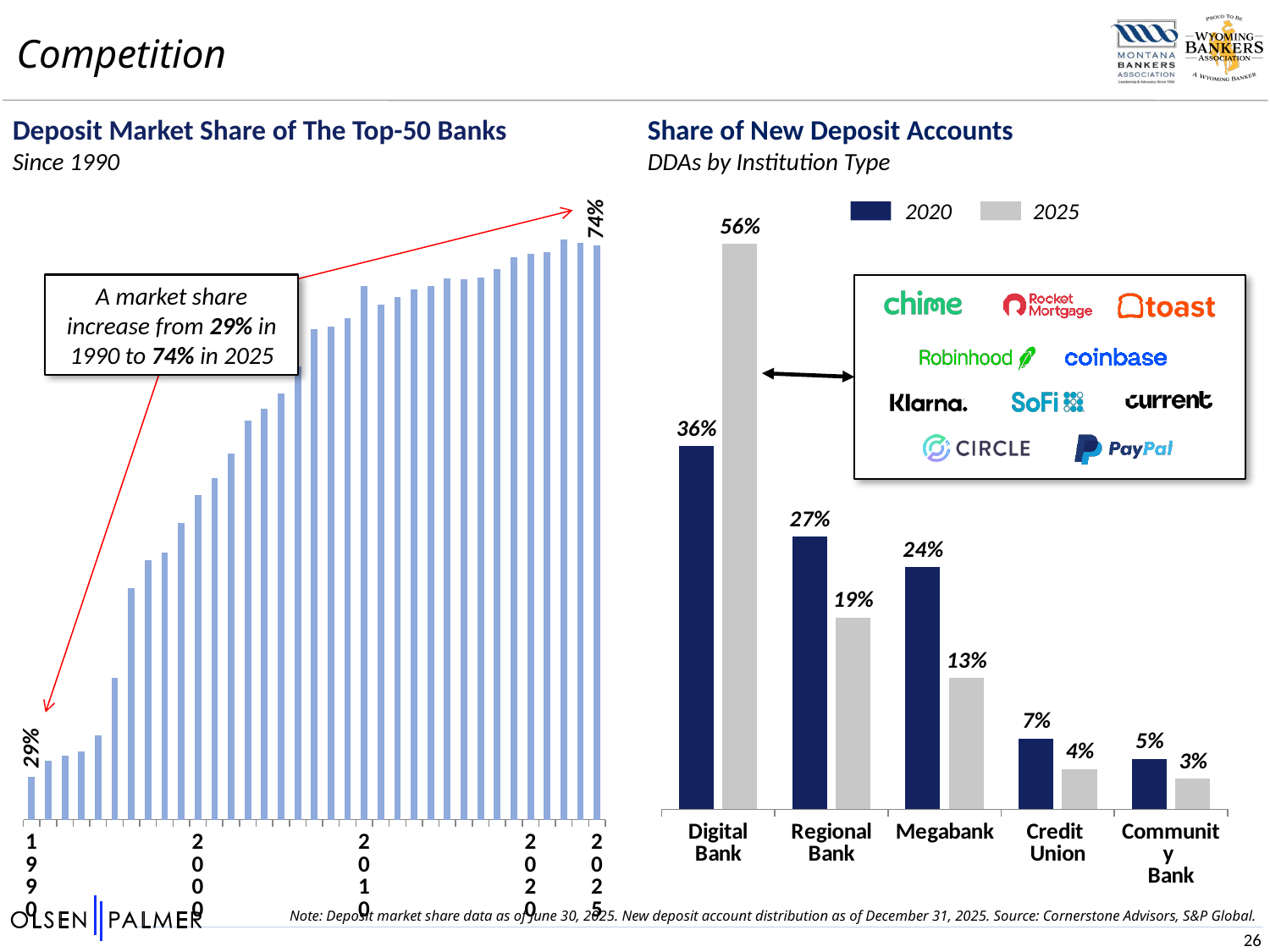
In the 'Share of New Deposit Accounts' chart, which is larger: the 2020 value for Credit Union or the 2020 value for Community Bank? Credit Union In the 'Share of New Deposit Accounts' chart, what is the 2025 value for Megabank? 13% What kind of chart is the 'Deposit Market Share of The Top-50 Banks' chart? Bar chart In the 'Share of New Deposit Accounts' chart, what is the 2020 value for Regional Bank? 27% In the 'Share of New Deposit Accounts' chart, what is the 2025 value for Digital Bank? 56% In the 'Deposit Market Share of The Top-50 Banks' chart, what is the value for 1990? 29% In the 'Share of New Deposit Accounts' chart, which institution type has the highest 2025 value? Digital Bank In the 'Share of New Deposit Accounts' chart, which institution type has the lowest 2025 value? Community Bank How many series does the legend of the 'Share of New Deposit Accounts' chart list? 2 In the 'Share of New Deposit Accounts' chart, what is the difference between the 2025 and 2020 values for Digital Bank? 20% How many institution types are shown on the x axis of the 'Share of New Deposit Accounts' chart? 5 In the 'Deposit Market Share of The Top-50 Banks' chart, what is the value for 2025? 74%